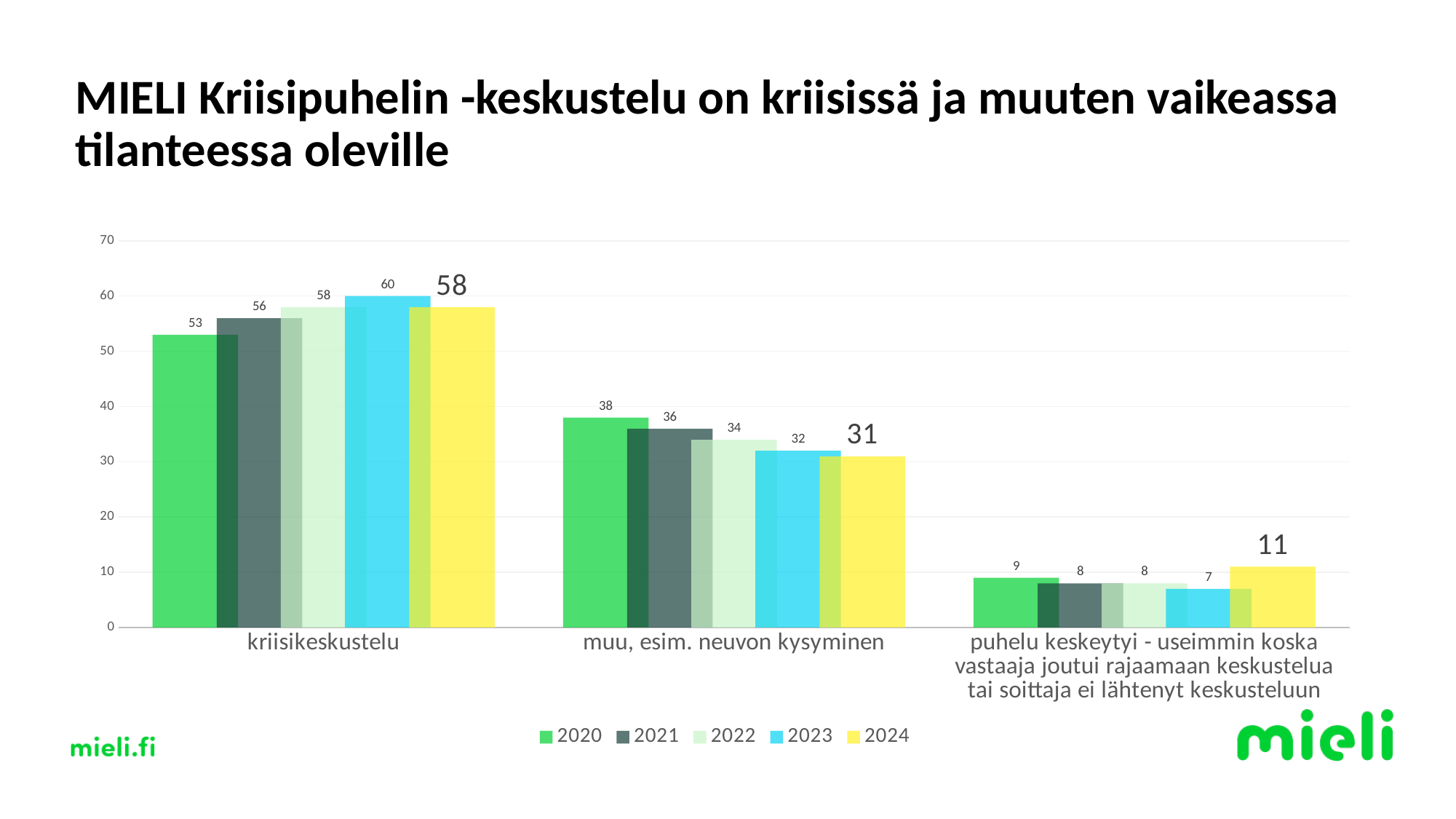
How many series does the legend list? 5 What kind of chart is shown on the slide? bar chart Is the 2021 value for muu, esim. neuvon kysyminen greater or less than 30? greater Which year has the highest value for kriisikeskustelu? 2023 What is the difference between the 2020 and 2024 values for kriisikeskustelu? 5 What is the value for kriisikeskustelu in 2024? 58 Which year has the lowest value for muu, esim. neuvon kysyminen? 2024 Which is larger for the 'puhelu keskeytyi' category: the 2020 value or the 2024 value? 2024 How many categories are shown on the x axis? 3 What is the value for muu, esim. neuvon kysyminen in 2020? 38 What is the value for the 'puhelu keskeytyi' category in 2023? 7 Which colour represents 2023 in the legend? blue